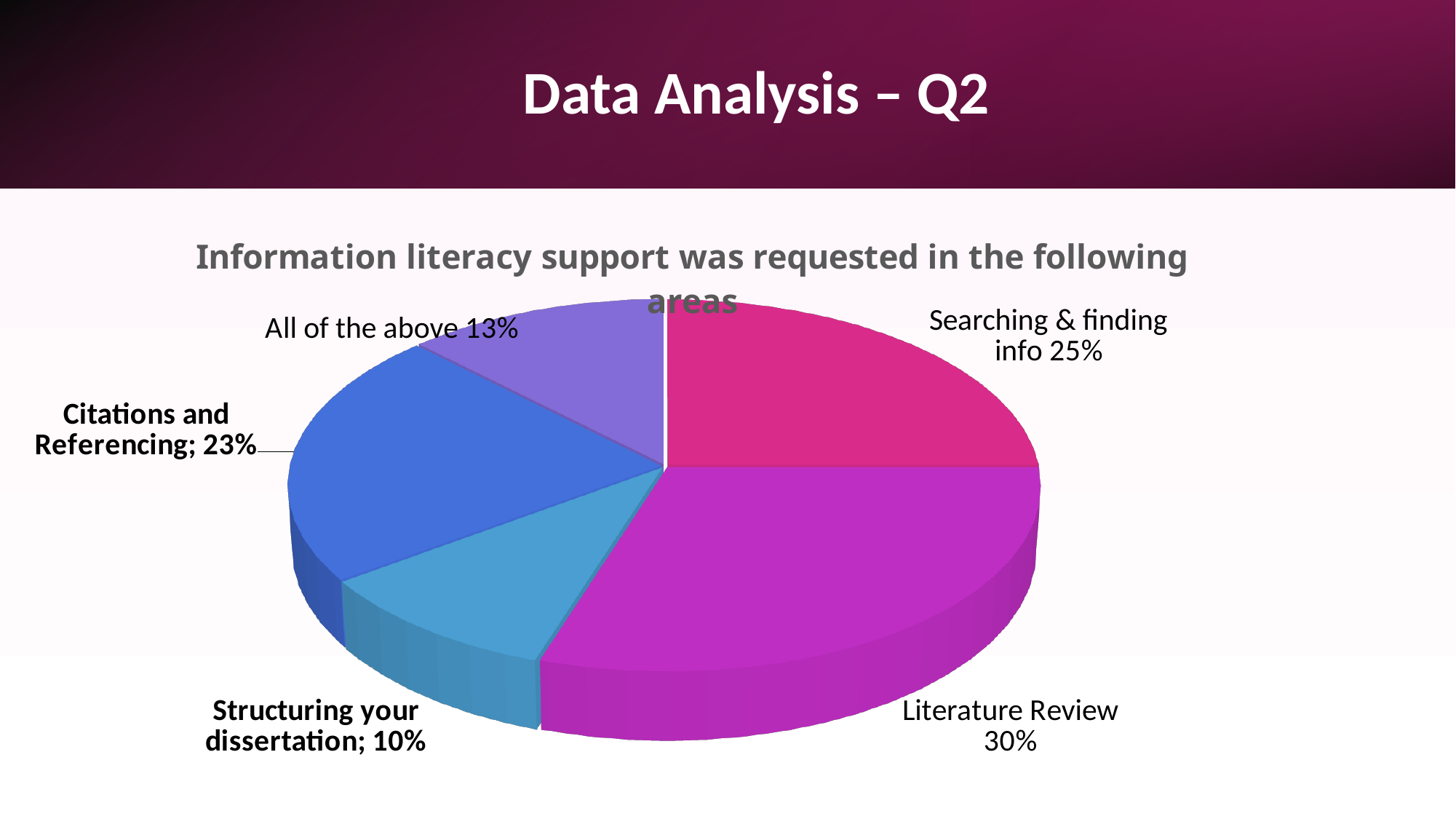
What is the title of the chart? Information literacy support was requested in the following areas What share of the pie is Citations and Referencing? 23% What share of the pie is All of the above? 13% Which is larger, the share for Citations and Referencing or the share for All of the above? Citations and Referencing What kind of chart is shown on the slide? Pie chart Which category has the largest share of the pie? Literature Review What share of the pie is Structuring your dissertation? 10% What is the difference in percentage points between Literature Review and Searching & finding info? 5% Which category has the smallest share of the pie? Structuring your dissertation How many slices does the pie chart have? 5